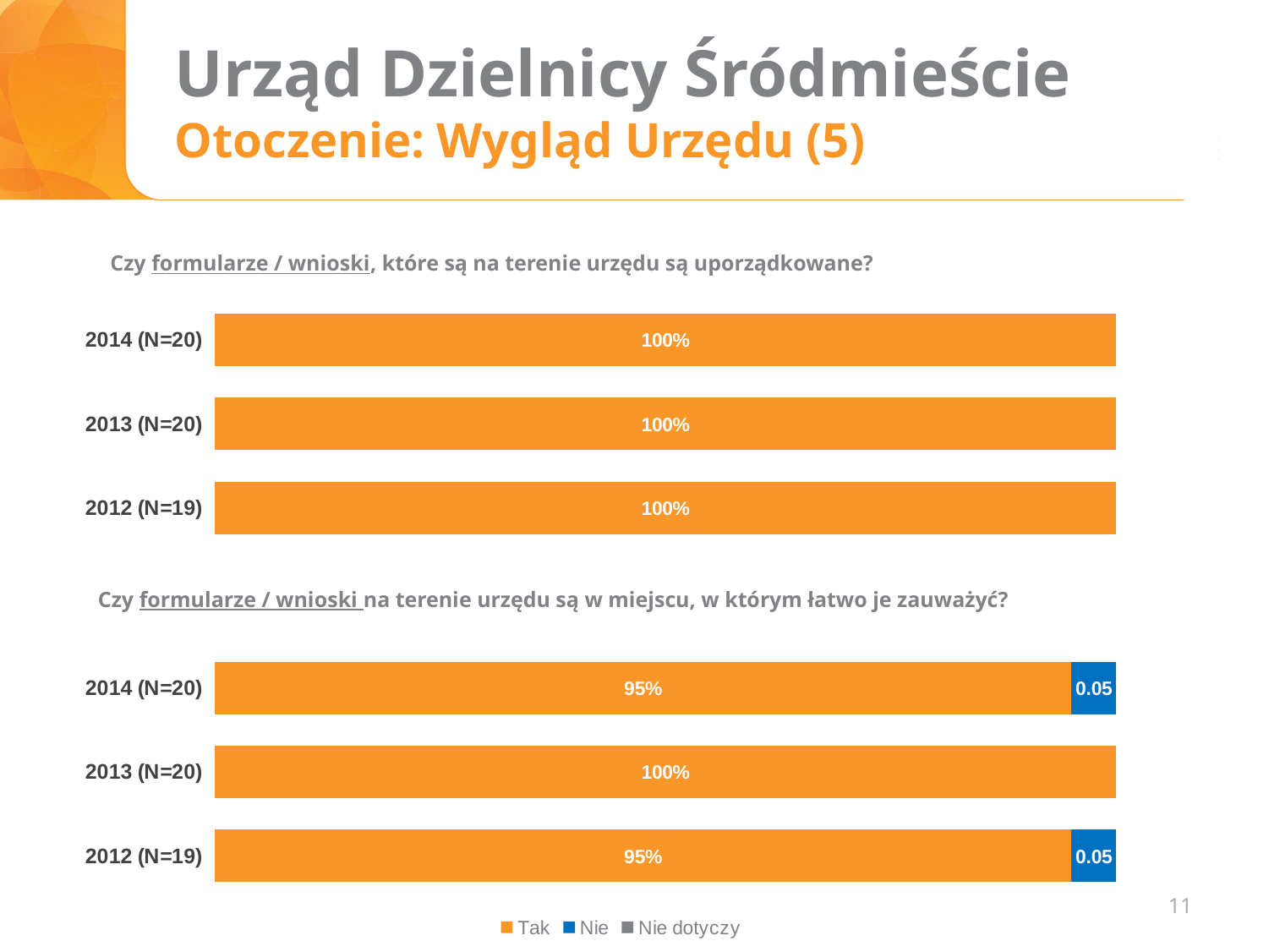
In the bottom chart ("Czy formularze / wnioski na terenie urzędu są w miejscu, w którym łatwo je zauważyć?"), what is the difference between the Tak value for 2013 (N=20) and the Tak value for 2014 (N=20)? 5% In the bottom chart ("Czy formularze / wnioski na terenie urzędu są w miejscu, w którym łatwo je zauważyć?"), how many series does the legend list? 3 In the top chart ("Czy formularze / wnioski, które są na terenie urzędu są uporządkowane?"), how many categories are shown? 3 In the top chart ("Czy formularze / wnioski, które są na terenie urzędu są uporządkowane?"), what is the value for 2012 (N=19)? 100% In the bottom chart ("Czy formularze / wnioski na terenie urzędu są w miejscu, w którym łatwo je zauważyć?"), what is the Nie value for 2012 (N=19)? 0.05 In the bottom chart ("Czy formularze / wnioski na terenie urzędu są w miejscu, w którym łatwo je zauważyć?"), which year has the highest Tak value? 2013 (N=20) In the top chart ("Czy formularze / wnioski, które są na terenie urzędu są uporządkowane?"), what is the value for 2014 (N=20)? 100% What type of chart is the bottom chart ("Czy formularze / wnioski na terenie urzędu są w miejscu, w którym łatwo je zauważyć?")? Stacked bar chart In the bottom chart ("Czy formularze / wnioski na terenie urzędu są w miejscu, w którym łatwo je zauważyć?"), what colour represents the Nie series? Blue In the bottom chart ("Czy formularze / wnioski na terenie urzędu są w miejscu, w którym łatwo je zauważyć?"), which is larger: the Tak value for 2013 (N=20) or the Tak value for 2012 (N=19)? 2013 (N=20) In the bottom chart ("Czy formularze / wnioski na terenie urzędu są w miejscu, w którym łatwo je zauważyć?"), what is the Tak value for 2013 (N=20)? 100% In the bottom chart ("Czy formularze / wnioski na terenie urzędu są w miejscu, w którym łatwo je zauważyć?"), what is the Tak value for 2014 (N=20)? 95%